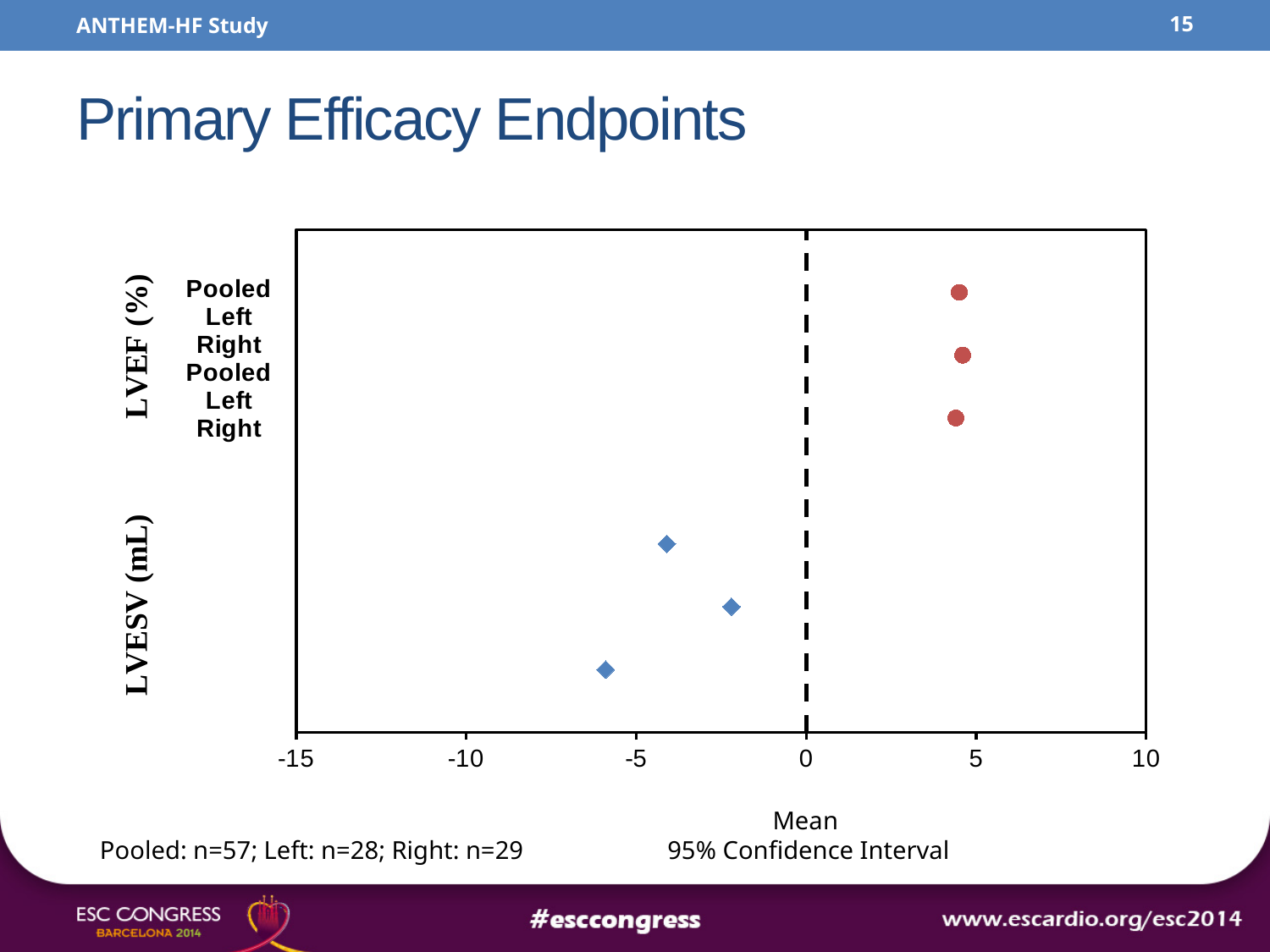
What kind of chart is shown on the slide? scatter chart Is the value for the middle LVESV (mL) point greater or less than -5? greater How many data points are plotted on the chart? 6 What does the x axis represent according to the label below the chart? Mean 95% Confidence Interval What is the minimum value shown on the x axis? -15 How many LVESV (mL) data points (blue diamonds) are plotted? 3 Which LVESV (mL) point has the lowest (most negative) value: the top, middle or bottom blue diamond? bottom Is the value for the Right LVEF (%) point greater or less than 5? less Is the value for the lowest LVESV (mL) point (bottom blue diamond) greater or less than -5? less How many LVEF (%) data points (red circles) are plotted? 3